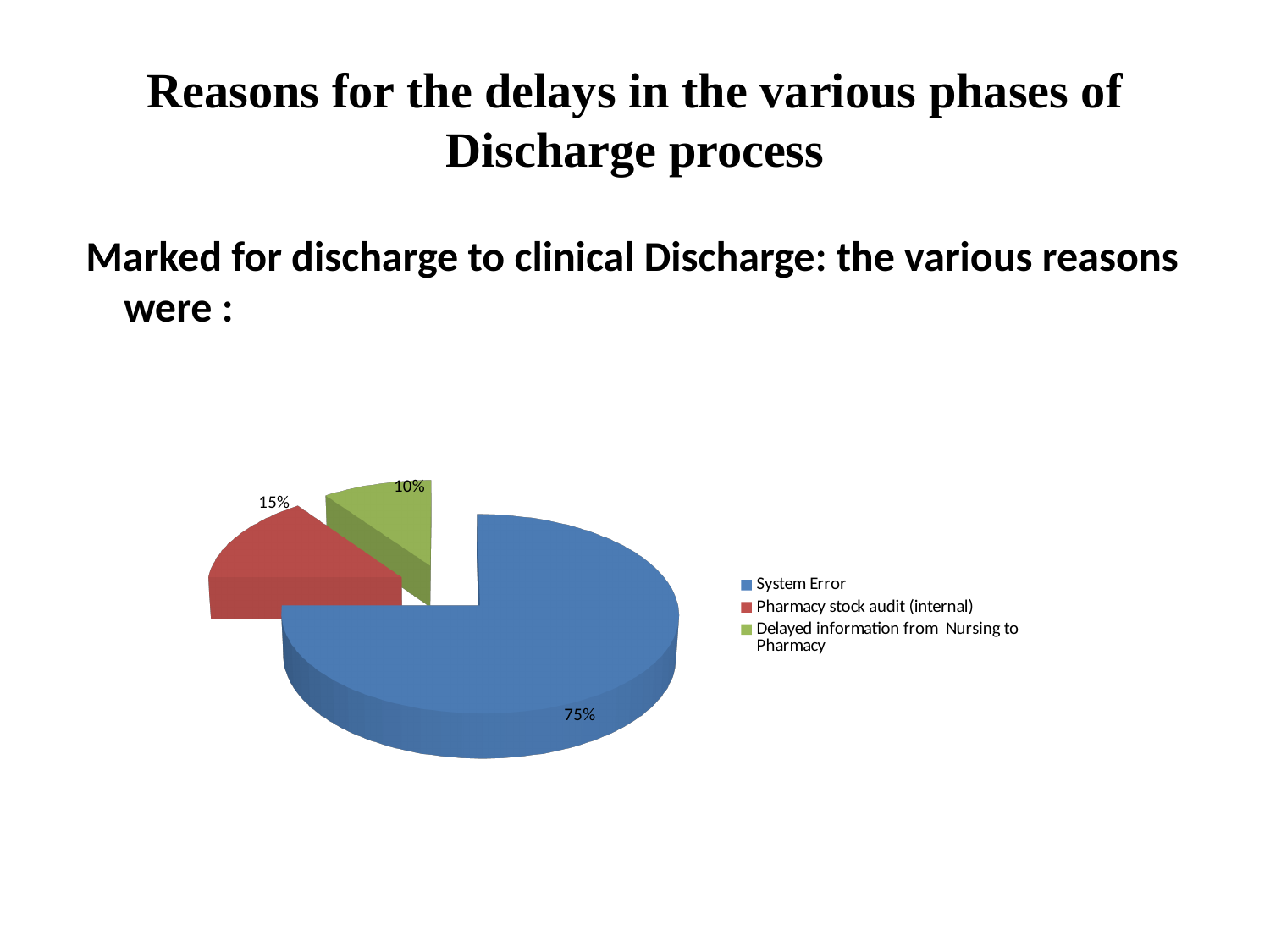
How many slices does the pie chart have? 3 Which reason has the largest slice of the pie? System Error What colour is the System Error slice in the pie chart? blue How many entries does the legend list? 3 What is the difference in percentage points between Pharmacy stock audit (internal) and Delayed information from Nursing to Pharmacy? 5 What kind of chart is shown on the slide? pie chart What share of the pie does Delayed information from Nursing to Pharmacy account for? 10% What is the difference in percentage points between System Error and Pharmacy stock audit (internal)? 60 Which is larger: the share for Pharmacy stock audit (internal) or the share for Delayed information from Nursing to Pharmacy? Pharmacy stock audit (internal) What share of the pie does Pharmacy stock audit (internal) account for? 15% Which reason has the smallest slice of the pie? Delayed information from Nursing to Pharmacy What share of the pie does System Error account for? 75%